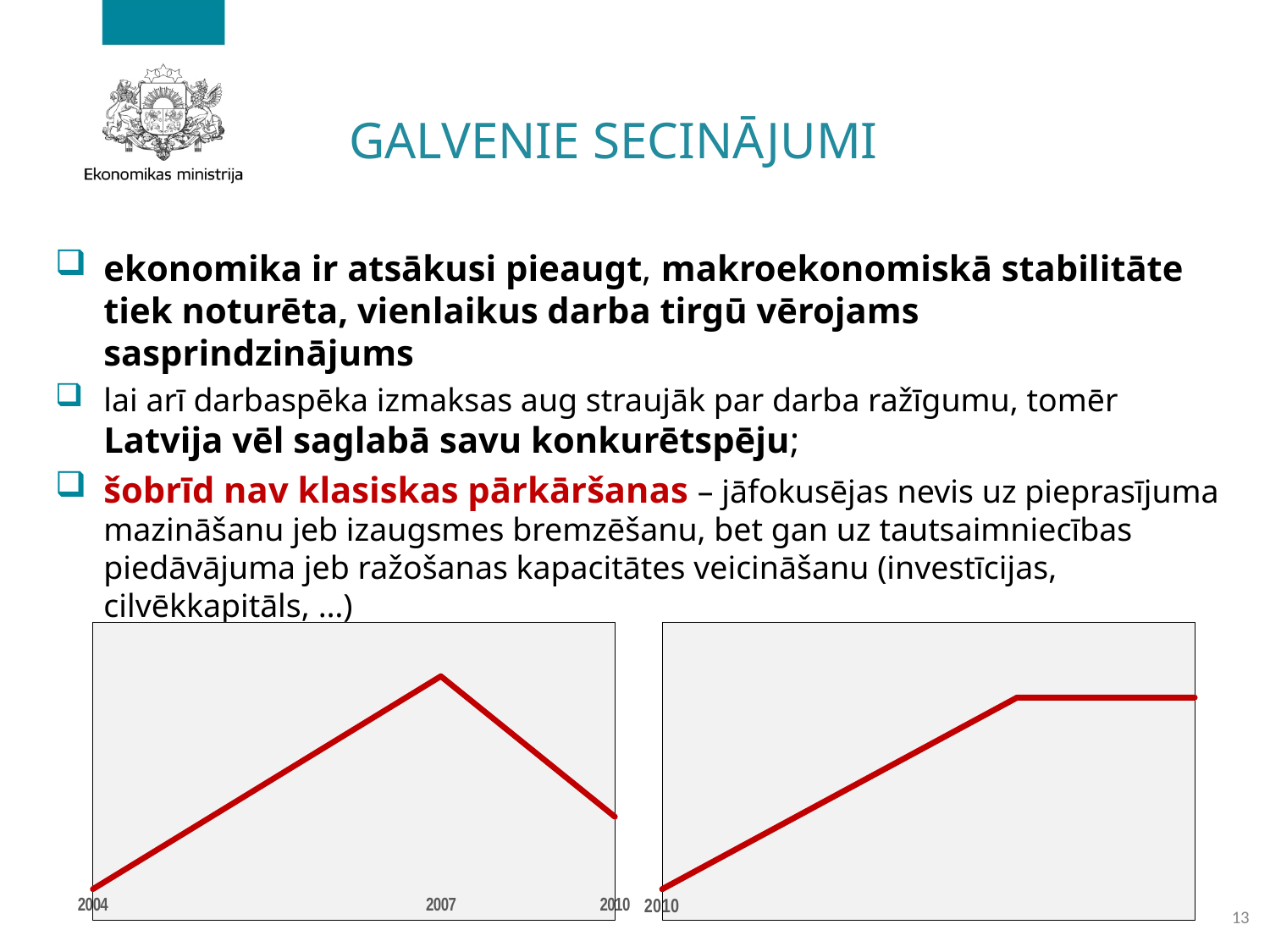
In the left chart, is the value for 2007 higher or lower than the value for 2010? higher In the left chart, is the value for 2010 higher or lower than the value for 2004? higher In the right chart, does the line rise, fall or stay flat in its final segment? stay flat In the right chart, does the line rise, fall or stay flat in its first segment starting from 2010? rise How many year labels are shown on the x axis of the left chart? 3 In the left chart, does the line rise or fall between 2007 and 2010? fall In the left chart, at which labelled year does the line reach its highest point? 2007 What colour is the line in the left chart? red In the left chart, which labelled year has the lowest point on the line? 2004 What kind of chart is the right chart on the slide? line chart What kind of chart is the left chart on the slide? line chart